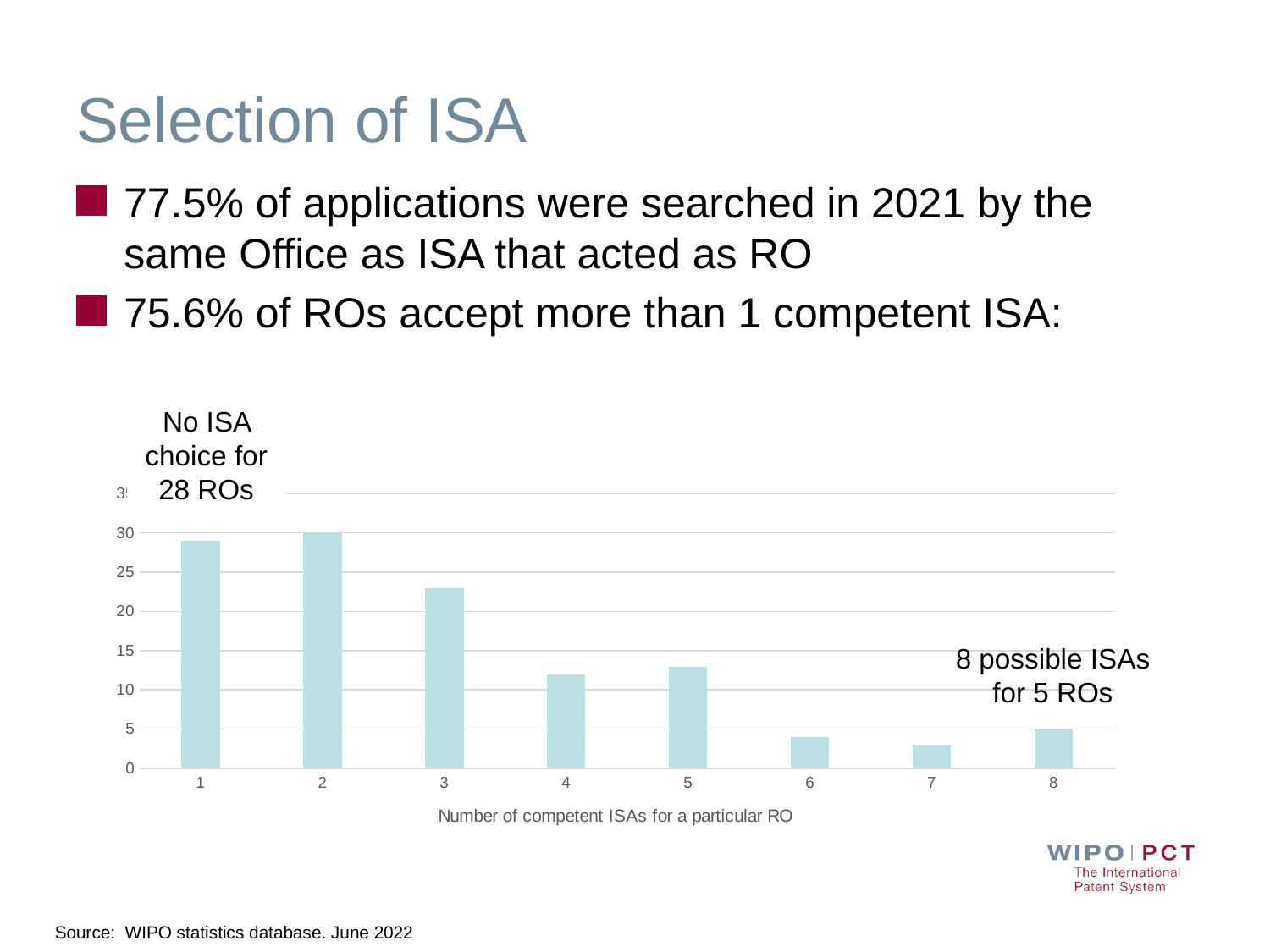
How many ROs have 8 possible ISAs, according to the chart annotation? 5 Is the value for category 4 greater or less than 10? greater What kind of chart is shown on the slide? bar chart Which category has the lowest bar in the chart? 7 Is the value for category 3 greater or less than 20? greater Which is larger, the value for category 3 or the value for category 5? category 3 What is the value for category 2 (two competent ISAs)? 30 Is the value for category 1 greater or less than 25? greater What is the x-axis title of the chart? Number of competent ISAs for a particular RO How many categories are shown on the x axis of the chart? 8 Do the values generally rise or fall as the number of competent ISAs increases from 1 to 8? fall